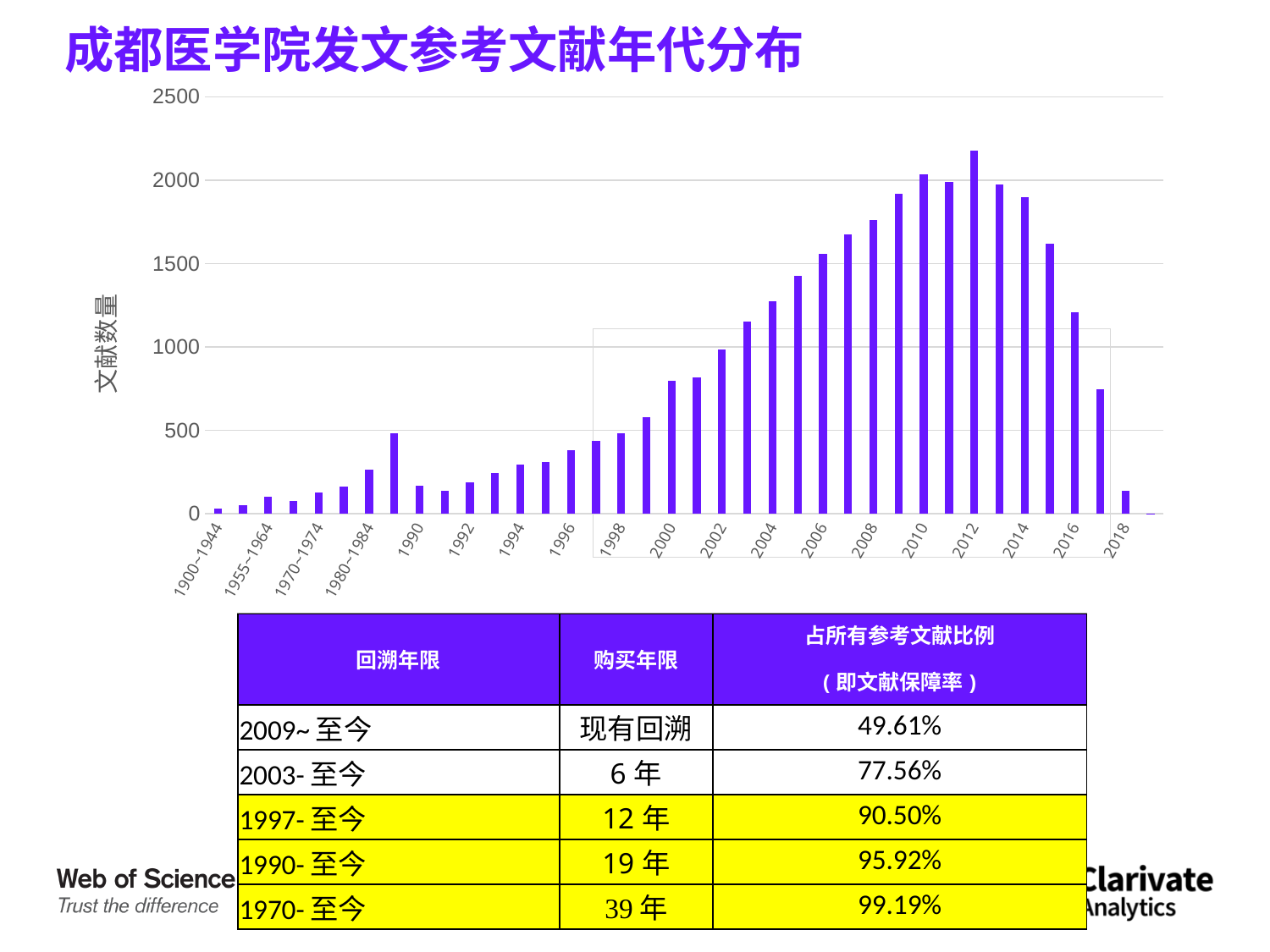
Do the values rise or fall from 2012 to 2018? fall Is the value for 2004 greater or less than 1000? greater Is the value for 2018 greater or less than 500? less Which has the larger value, 2012 or 2016? 2012 Which has the larger value, 1990 or 2000? 2000 Which year has the highest bar in the chart? 2012 Is the value for 2008 greater or less than 2000? less What is the label on the vertical axis of the chart? 文献数量 What is the title of the chart? 成都医学院发文参考文献年代分布 What kind of chart is shown on the slide? bar chart